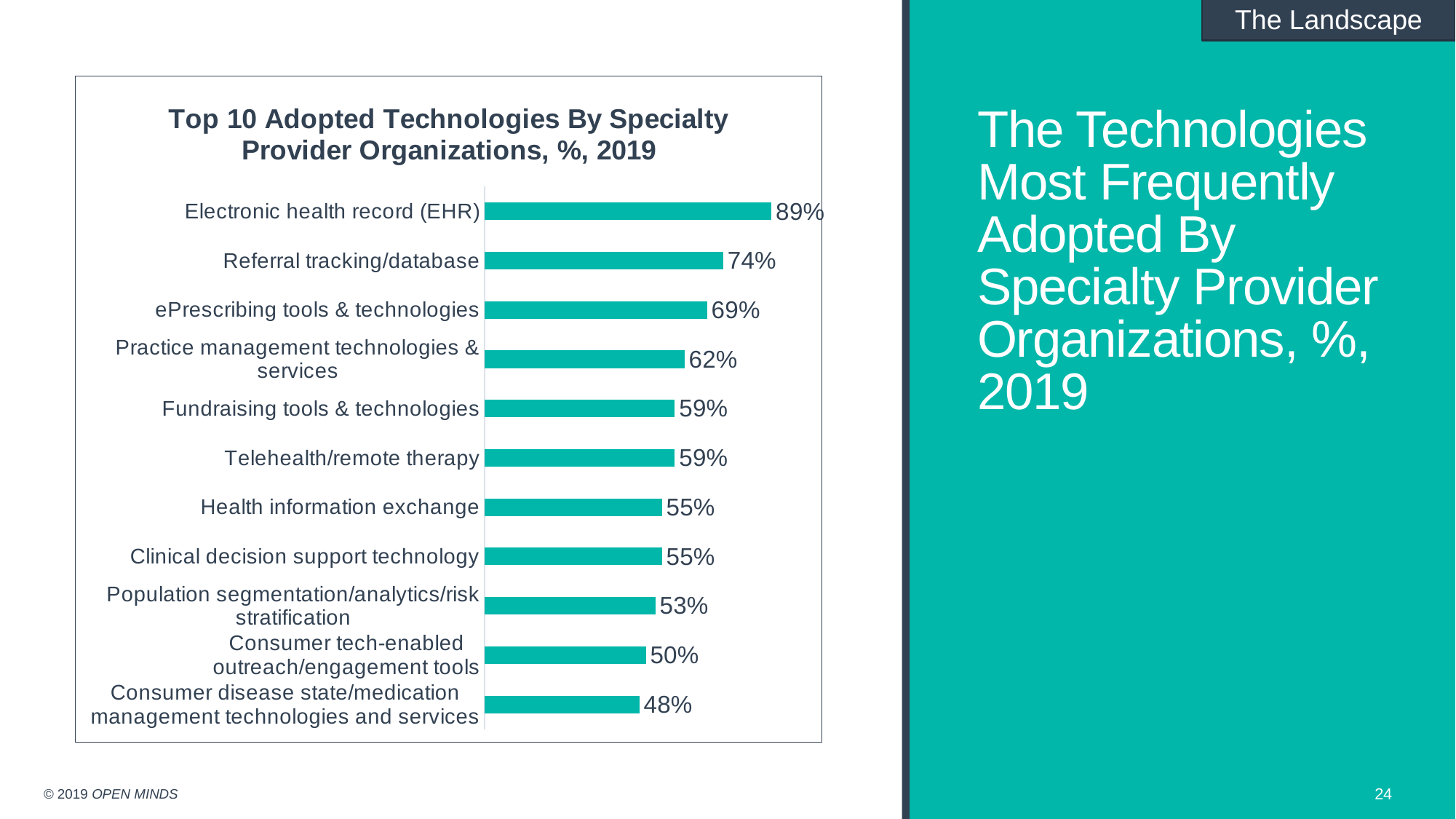
What kind of chart is shown on the slide? Bar chart Which is larger, the value for Health information exchange or the value for Population segmentation/analytics/risk stratification? Health information exchange How many categories are shown in the chart? 11 What is the value for Electronic health record (EHR)? 89% What is the difference between the values for ePrescribing tools & technologies and Practice management technologies & services? 7% Which category has the highest value? Electronic health record (EHR) What is the title of the chart? Top 10 Adopted Technologies By Specialty Provider Organizations, %, 2019 What is the difference between the values for Electronic health record (EHR) and Referral tracking/database? 15% What is the value for Referral tracking/database? 74% What is the value for Consumer disease state/medication management technologies and services? 48% What is the value for Telehealth/remote therapy? 59% Which category has the lowest value? Consumer disease state/medication management technologies and services